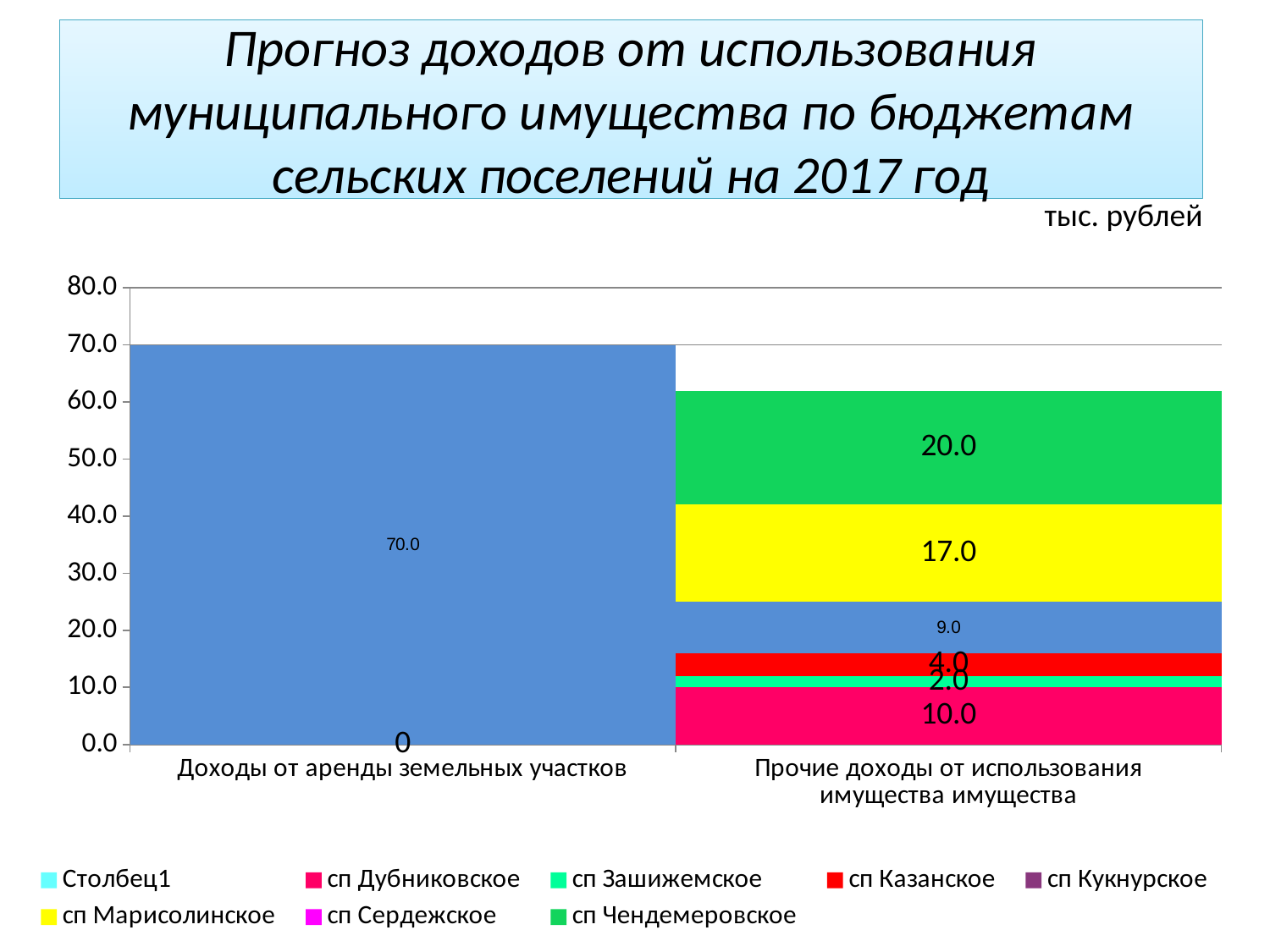
What is the value for сп Чендемеровское in the 'Прочие доходы от использования имущества имущества' bar? 20.0 What is the value for сп Зашижемское in the 'Прочие доходы от использования имущества имущества' bar? 2.0 How many categories are shown on the x axis? 2 Which series has the largest segment in the 'Прочие доходы от использования имущества имущества' bar? сп Чендемеровское What is the value for сп Марисолинское in the 'Прочие доходы от использования имущества имущества' bar? 17.0 How many series does the legend list? 8 What is the value for сп Казанское in the 'Прочие доходы от использования имущества имущества' bar? 4.0 What is the difference between the values for сп Чендемеровское and сп Марисолинское in the 'Прочие доходы от использования имущества имущества' bar? 3.0 What is the total of the 'Прочие доходы от использования имущества имущества' stacked bar? 62.0 What is the value for сп Дубниковское in the 'Прочие доходы от использования имущества имущества' bar? 10.0 What unit of measurement is stated above the chart? тыс. рублей What kind of chart is shown on the slide? stacked bar chart